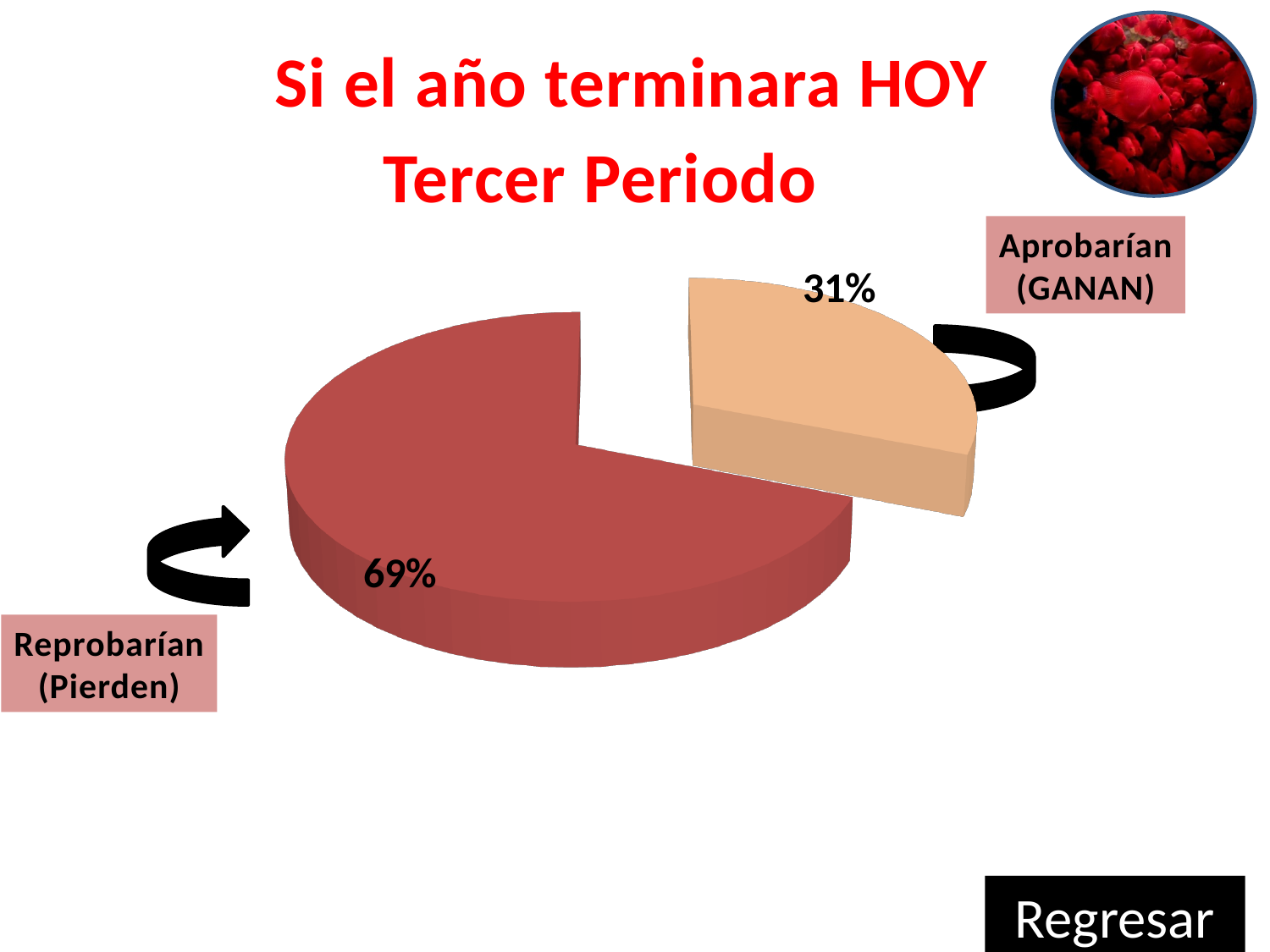
Which is larger, the Aprobarían (GANAN) slice or the Reprobarían (Pierden) slice? Reprobarían (Pierden) What kind of chart is shown on the slide? Pie chart What share of the pie is labelled Reprobarían (Pierden)? 69% What is the difference in percentage points between the Reprobarían (Pierden) slice and the Aprobarían (GANAN) slice? 38 What colour is the Aprobarían (GANAN) slice? Light orange (tan) Which slice of the pie is the smallest? Aprobarían (GANAN) How many slices does the pie chart have? 2 Which slice of the pie is the largest? Reprobarían (Pierden) What colour is the Reprobarían (Pierden) slice? Red What share of the pie is labelled Aprobarían (GANAN)? 31%